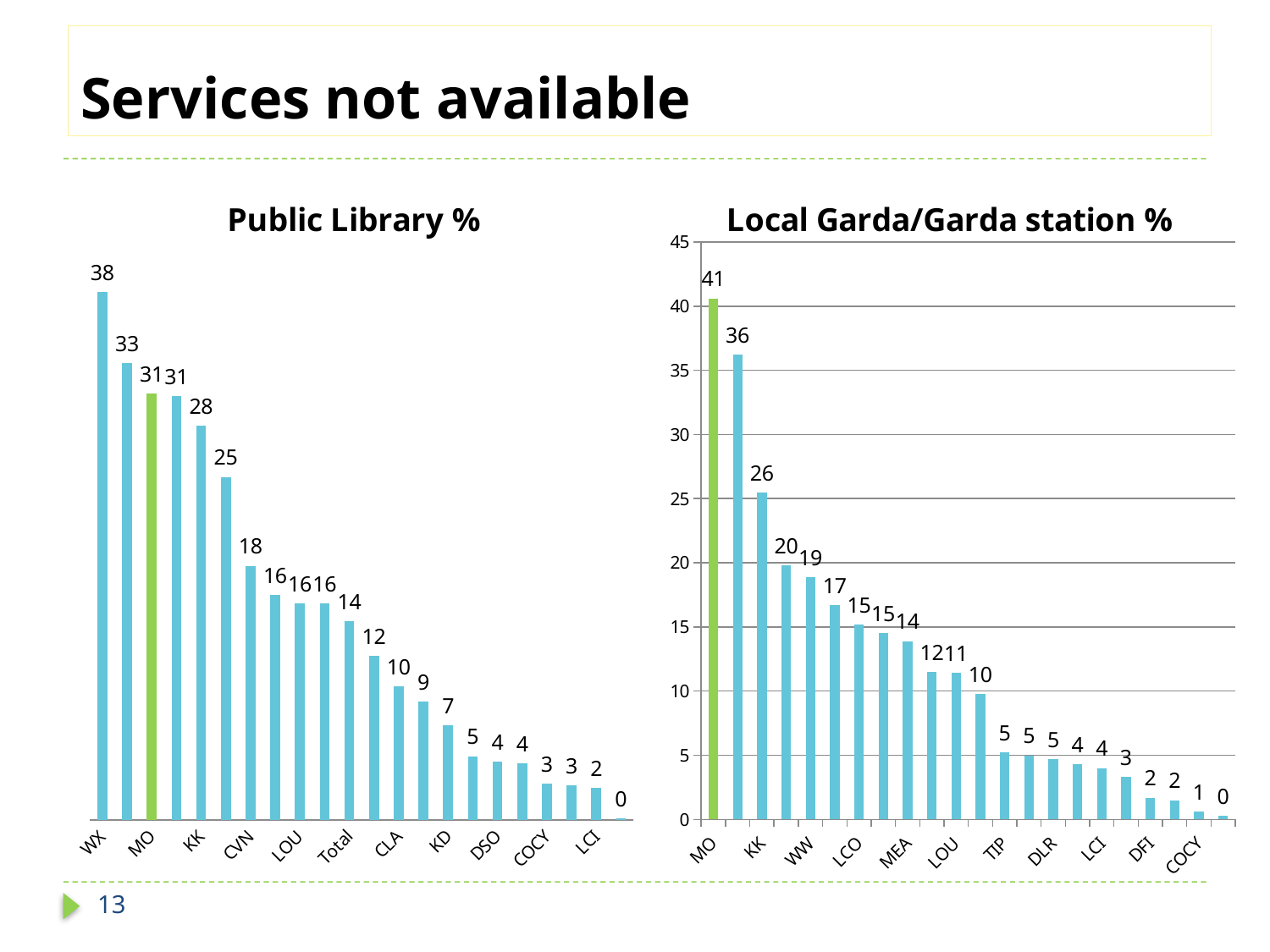
In the Local Garda/Garda station % chart, what is the value for KK? 26 In the Local Garda/Garda station % chart, what is the difference between the values for MO and KK? 15 In the Local Garda/Garda station % chart, which category has the highest value? MO In the Local Garda/Garda station % chart, which is larger, the value for KK or the value for WW? KK In the Public Library % chart, what is the value for WX? 38 What kind of chart is the Public Library % chart? bar chart In the Public Library % chart, what is the value for MO (the green bar)? 31 In the Public Library % chart, what is the difference between the values for WX and KK? 10 In the Local Garda/Garda station % chart, is the value for MO greater or less than 40? greater In the Local Garda/Garda station % chart, what is the value for MO? 41 In the Public Library % chart, which category has the highest value? WX In the Public Library % chart, what is the value for KK? 28